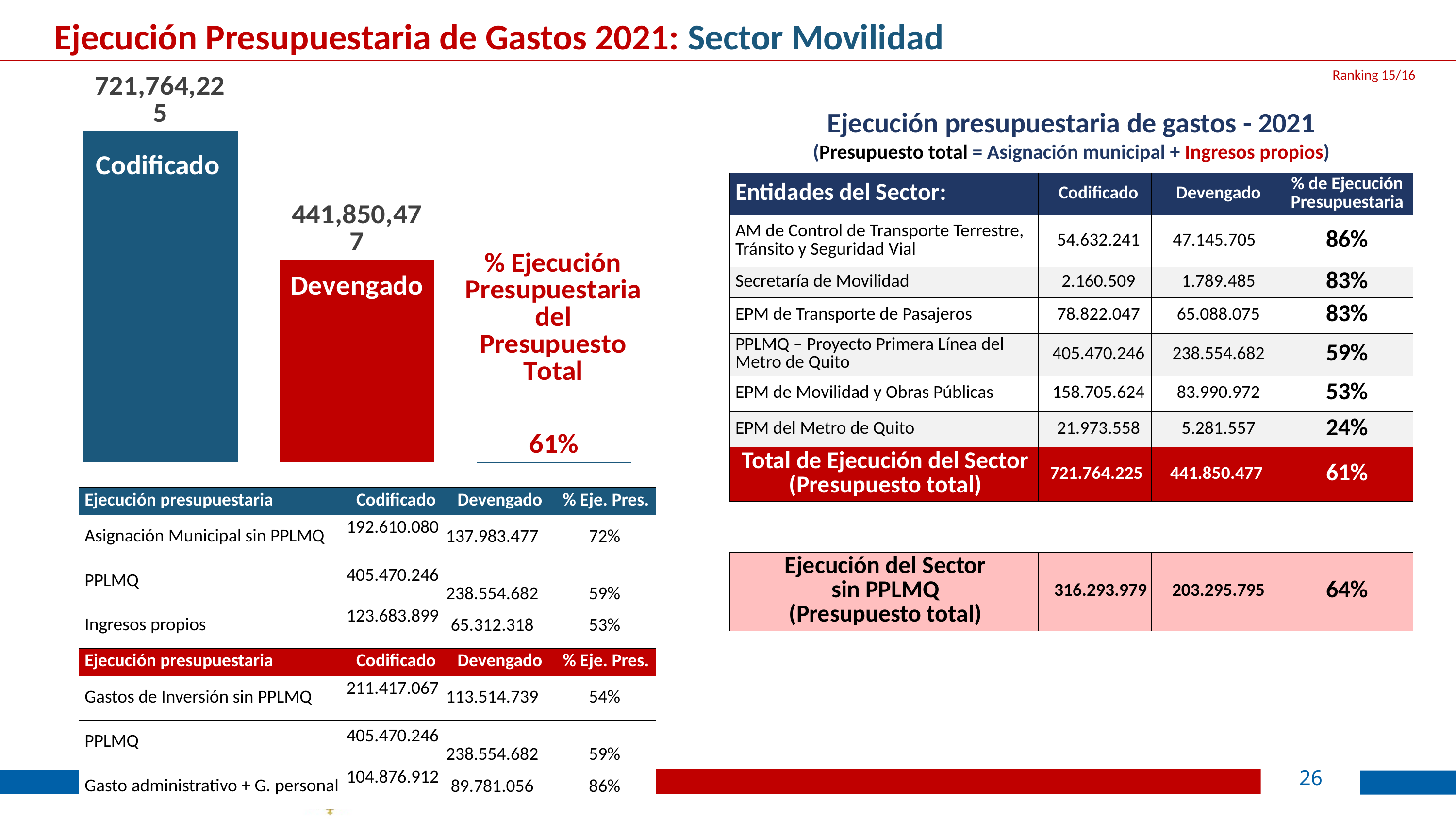
What is the value of the Codificado bar in the bar chart? 721,764,225 What is the difference between the Codificado and Devengado values in the bar chart? 279,913,748 What is the value of the Devengado bar in the bar chart? 441,850,477 Which bar in the bar chart is the highest? Codificado How many bars are shown in the bar chart? 2 What kind of chart is shown on the left of the slide? Bar chart In the bar chart, which is larger, Codificado or Devengado? Codificado Do the values in the bar chart rise or fall from the Codificado bar to the Devengado bar? Fall Which bar in the bar chart is the lowest? Devengado What percentage is shown next to the bar chart as the % Ejecución Presupuestaria del Presupuesto Total? 61% What colour is the Devengado bar in the bar chart? Red